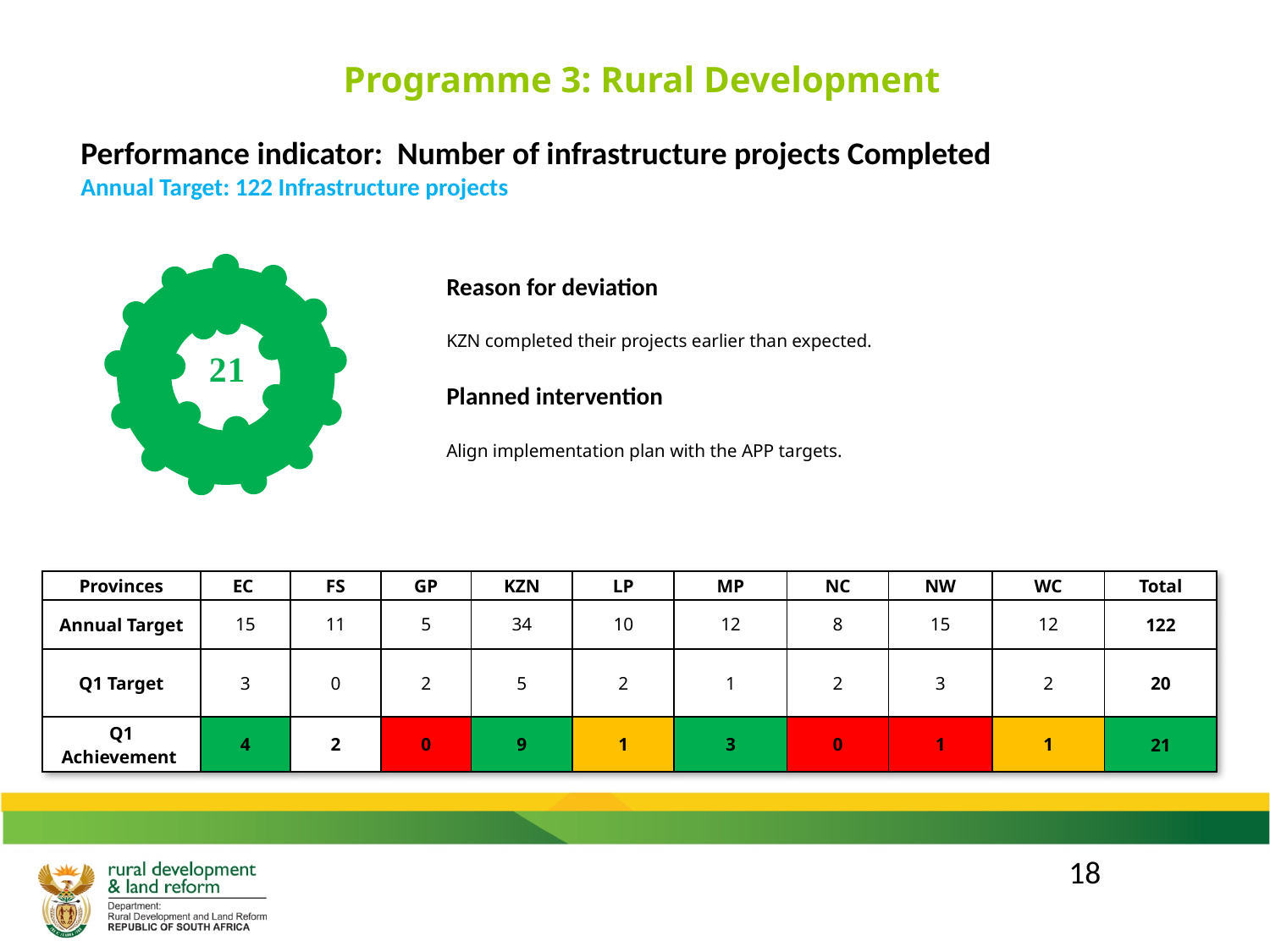
What colour is the ring chart on the left of the slide? green What value is displayed in the centre of the green ring chart? 21 Is the value shown in the centre of the ring chart greater or less than 122? less Is the value shown in the centre of the ring chart greater or less than 20? greater What kind of chart is the green graphic on the left of the slide? doughnut (ring) chart